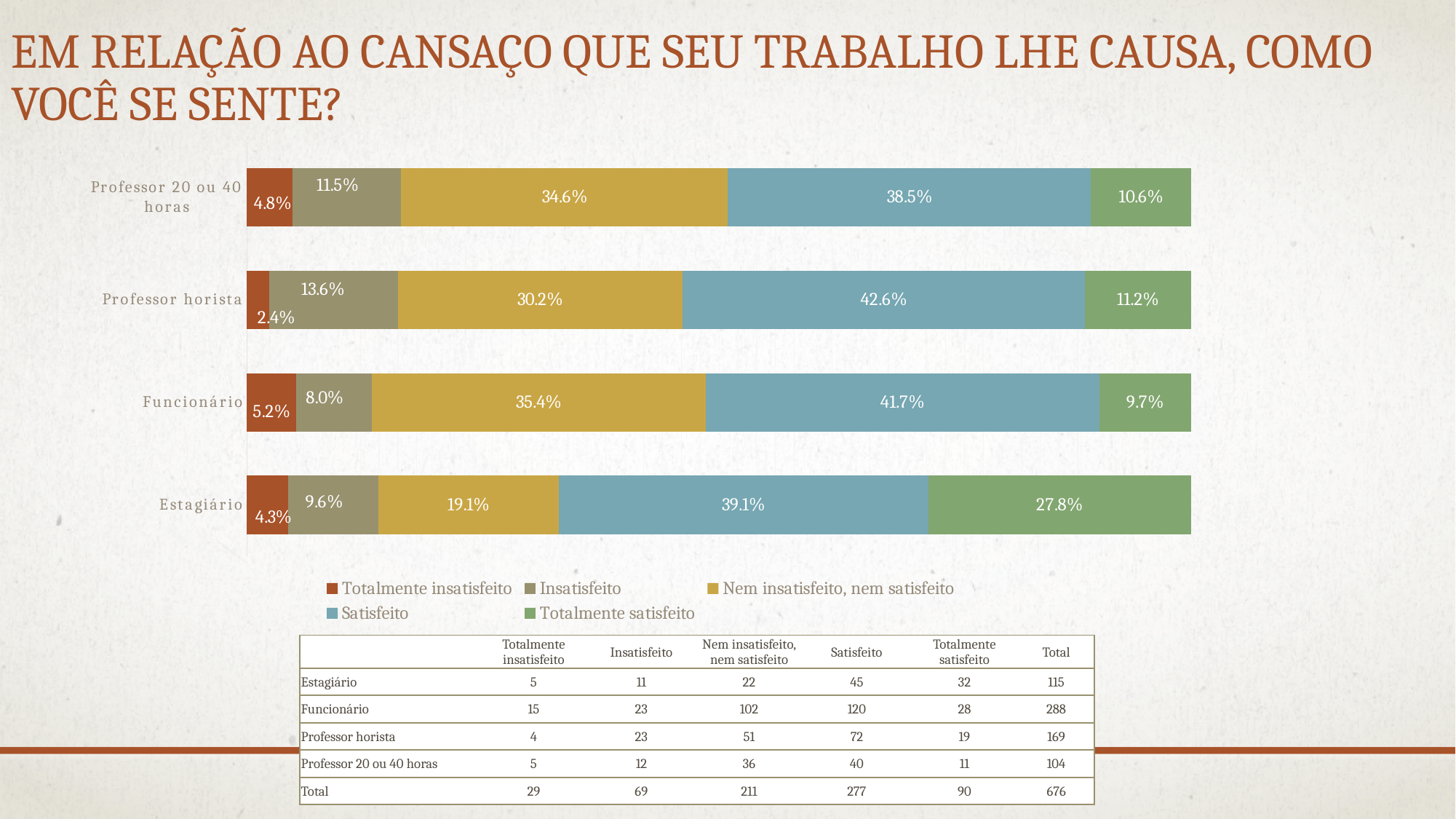
What is the difference between the Satisfeito values for Professor horista and Professor 20 ou 40 horas? 4.1 percentage points What is the value for Nem insatisfeito, nem satisfeito for Funcionário? 35.4% Which category has the lowest value for Totalmente insatisfeito? Professor horista What kind of chart is shown on the slide? Stacked bar chart What is the value for Satisfeito for Professor horista? 42.6% How many categories are shown on the chart? 4 Which is larger: the Insatisfeito value for Professor horista or for Funcionário? Professor horista Which category has the lowest value for Nem insatisfeito, nem satisfeito? Estagiário Which category has the highest value for Totalmente satisfeito? Estagiário What is the value for Totalmente satisfeito for Estagiário? 27.8% What is the value for Totalmente insatisfeito for Professor 20 ou 40 horas? 4.8% How many series does the legend list? 5